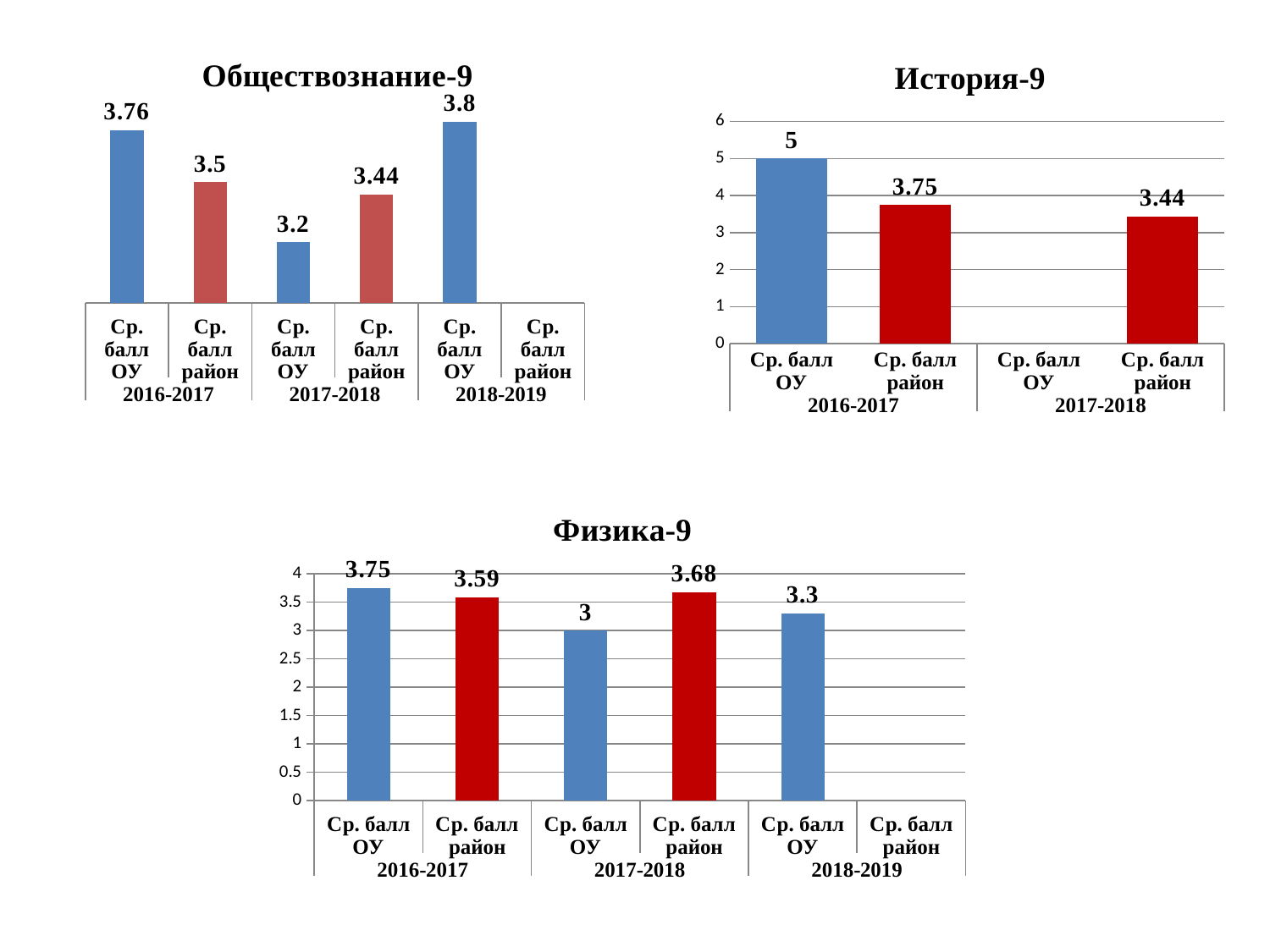
In the Физика-9 chart, what is the difference between Ср. балл район and Ср. балл ОУ for 2017-2018? 0.68 In the Обществознание-9 chart, which bar has the highest value? Ср. балл ОУ 2018-2019 In the История-9 chart, what is the value of Ср. балл ОУ for 2016-2017? 5 In the Обществознание-9 chart, what is the value of Ср. балл ОУ for 2016-2017? 3.76 In the Физика-9 chart, what is the value of Ср. балл ОУ for 2017-2018? 3 In the Физика-9 chart, how many bars are plotted? 5 In the Физика-9 chart, which bar has the lowest value? Ср. балл ОУ 2017-2018 In the История-9 chart, what is the value of Ср. балл район for 2017-2018? 3.44 In the Обществознание-9 chart, what is the difference between Ср. балл ОУ and Ср. балл район for 2016-2017? 0.26 In the Обществознание-9 chart, what is the value of Ср. балл район for 2017-2018? 3.44 What type of chart is the История-9 chart? Bar chart In the История-9 chart, which is larger: Ср. балл район for 2016-2017 or Ср. балл район for 2017-2018? Ср. балл район for 2016-2017